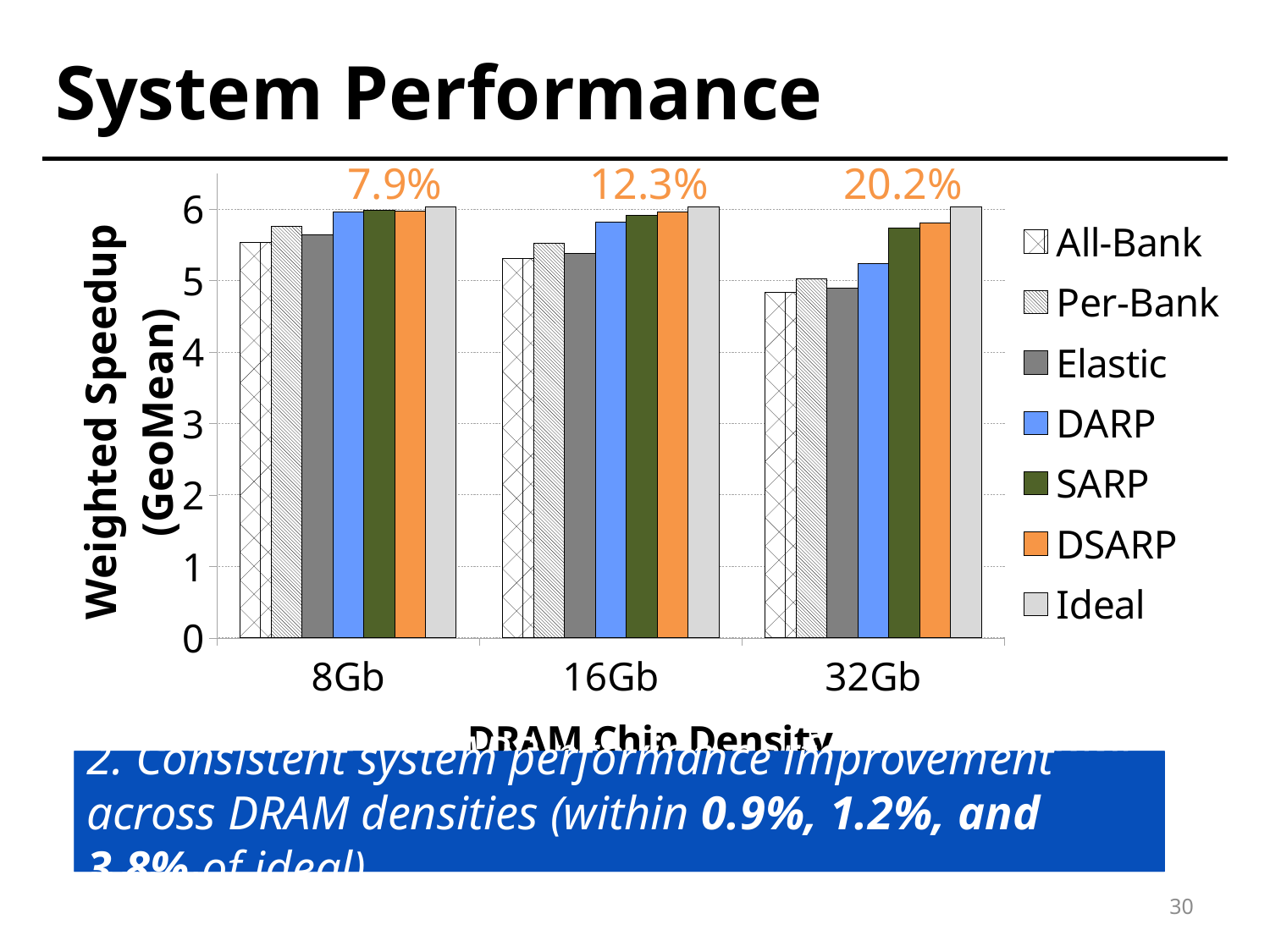
Is the value for Per-Bank at 16Gb greater or less than 5? greater How many DRAM chip density categories are shown on the x axis? 3 Which series has the highest value in the 32Gb group? Ideal Is the value for All-Bank at 8Gb greater or less than 5? greater What kind of chart is shown on the slide? bar chart How many series does the legend list? 7 Is the value for DARP at 32Gb greater or less than 5? greater Do the All-Bank values rise or fall as DRAM chip density increases from 8Gb to 32Gb? fall Which is larger at 32Gb, Ideal or All-Bank? Ideal Which is larger at 16Gb, DSARP or Elastic? DSARP What is the x-axis title of the chart? DRAM Chip Density What percentage is printed above the 16Gb group of bars? 12.3%